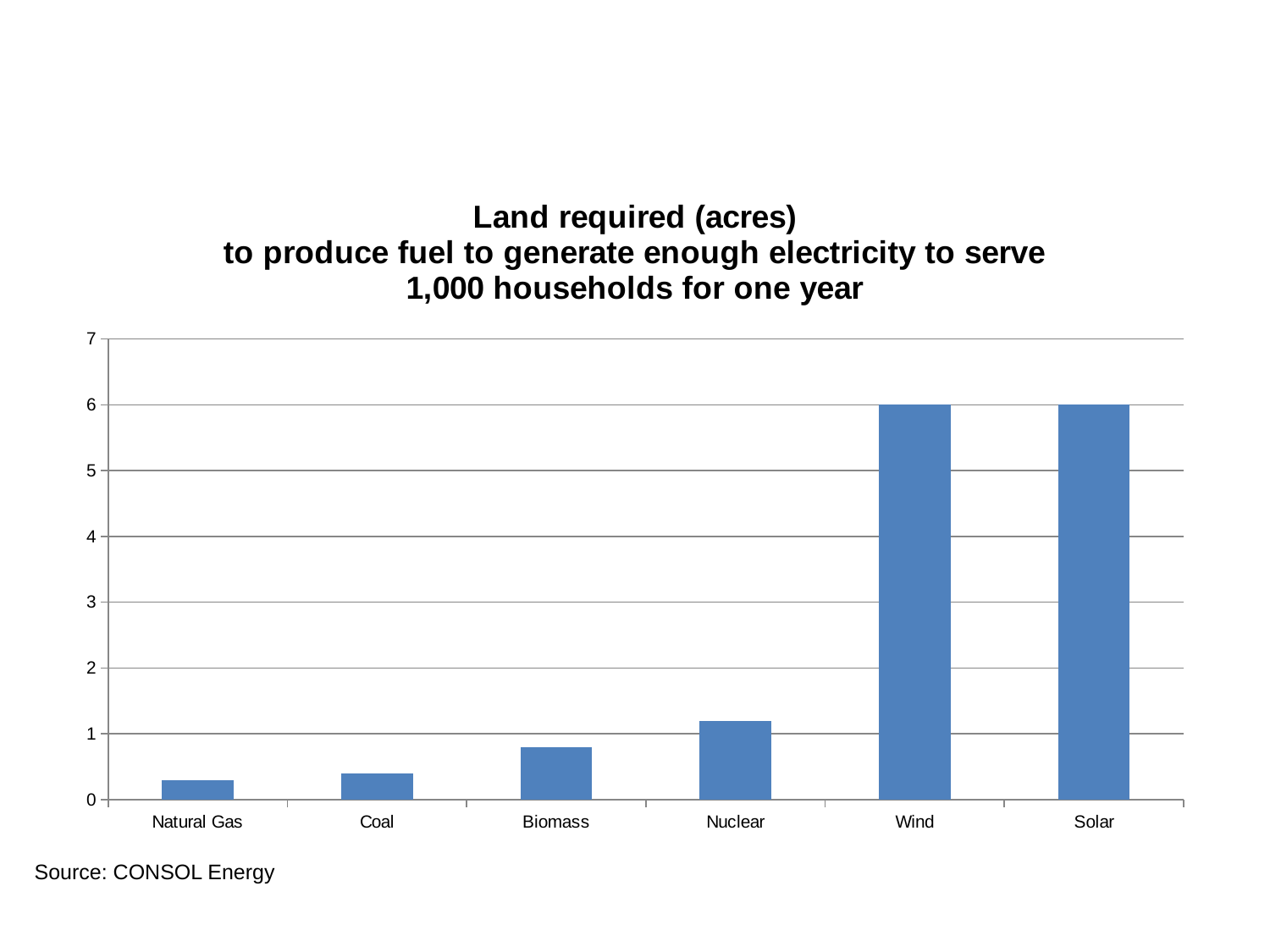
Is the value for Coal greater or less than 1? less Is the value for Nuclear greater or less than 1? greater How many fuel categories are shown on the chart? 6 Which requires more land, Solar or Coal? Solar What is the land required (acres) value for Wind? 6 Is the value for Biomass greater or less than 1? less What source is cited for the chart data? CONSOL Energy Which requires more land, Nuclear or Biomass? Nuclear What is the land required (acres) value for Solar? 6 Do the values generally rise or fall moving from Natural Gas to Solar along the x axis? Rise What type of chart is shown on the slide? Bar chart